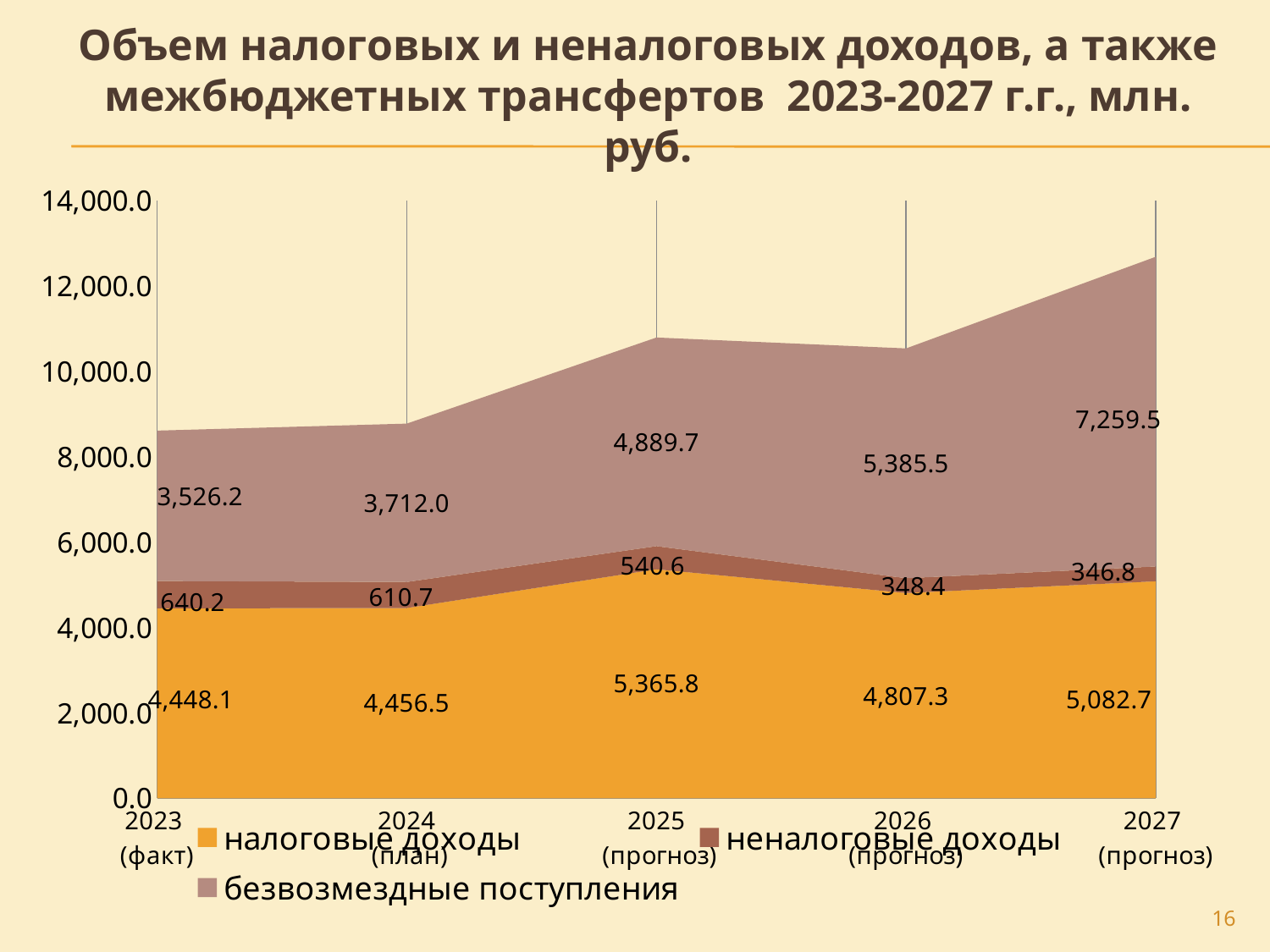
What is the difference between безвозмездные поступления in 2027 (прогноз) and in 2023 (факт)? 3,733.3 In which year is неналоговые доходы lowest? 2027 (прогноз) What is the total of all three series for 2027 (прогноз)? 12,689.0 What is the value of неналоговые доходы for 2023 (факт)? 640.2 What is the value of безвозмездные поступления for 2027 (прогноз)? 7,259.5 Which is larger: налоговые доходы in 2025 (прогноз) or in 2026 (прогноз)? 2025 (прогноз) What kind of chart is shown on the slide? Stacked area chart Does неналоговые доходы rise or fall from 2023 to 2027? Fall What is the value of налоговые доходы for 2025 (прогноз)? 5,365.8 How many years are shown on the x axis? 5 In which year is безвозмездные поступления highest? 2027 (прогноз) How many series does the legend list? 3